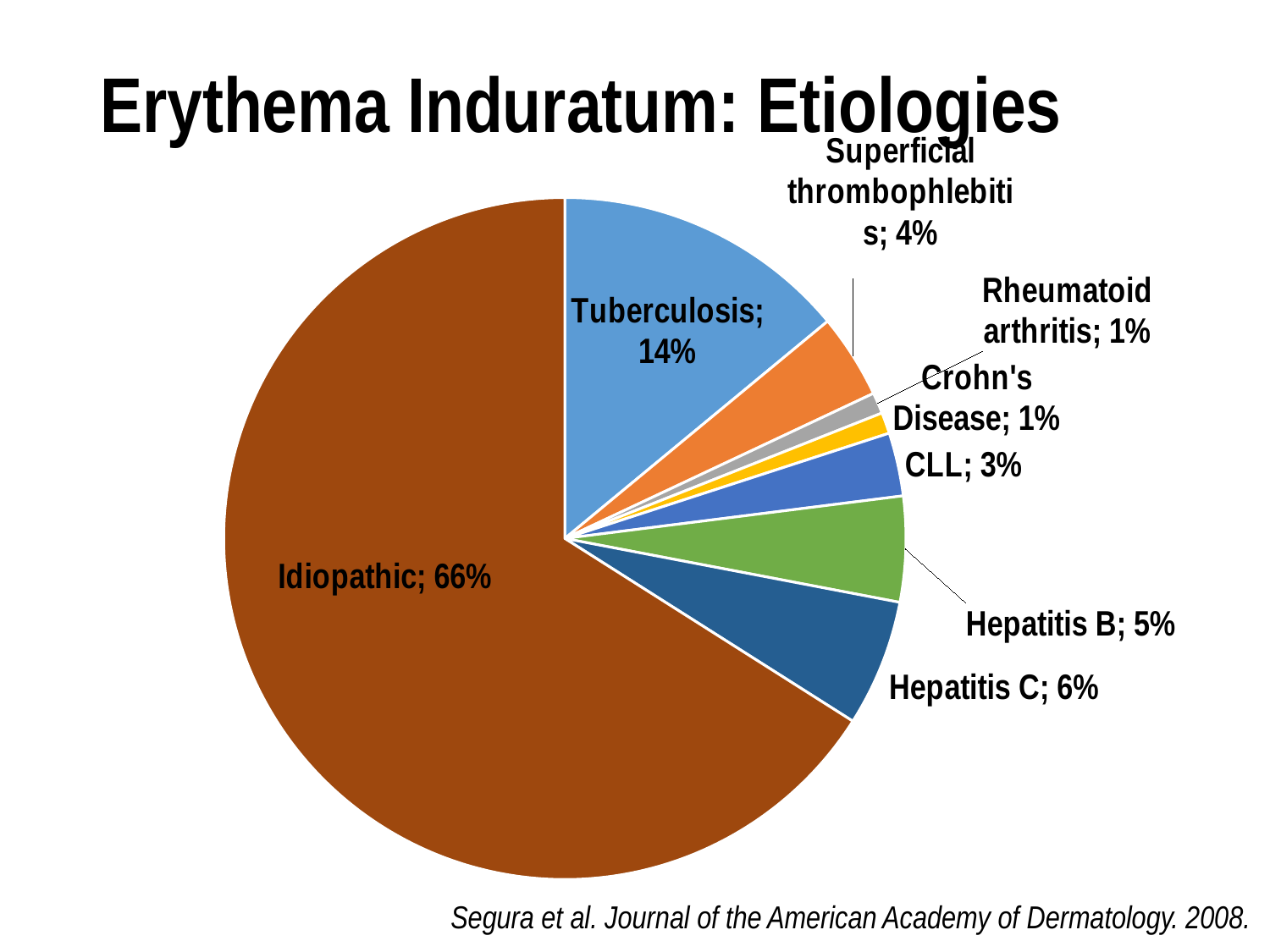
What type of chart is shown on the slide? Pie chart What colour is the Idiopathic slice? Brown What is the title of the slide containing the pie chart? Erythema Induratum: Etiologies What is the value shown for Superficial thrombophlebitis? 4% What percentage of the pie is labelled Idiopathic? 66% What is the value shown for CLL? 3% What is the value shown for Tuberculosis? 14% Which etiology has the largest slice of the pie? Idiopathic What is the value shown for Hepatitis C? 6% Which is larger, the slice for Hepatitis B or the slice for Hepatitis C? Hepatitis C How many slices does the pie chart have? 8 What is the difference between the Idiopathic and Tuberculosis percentages? 52%